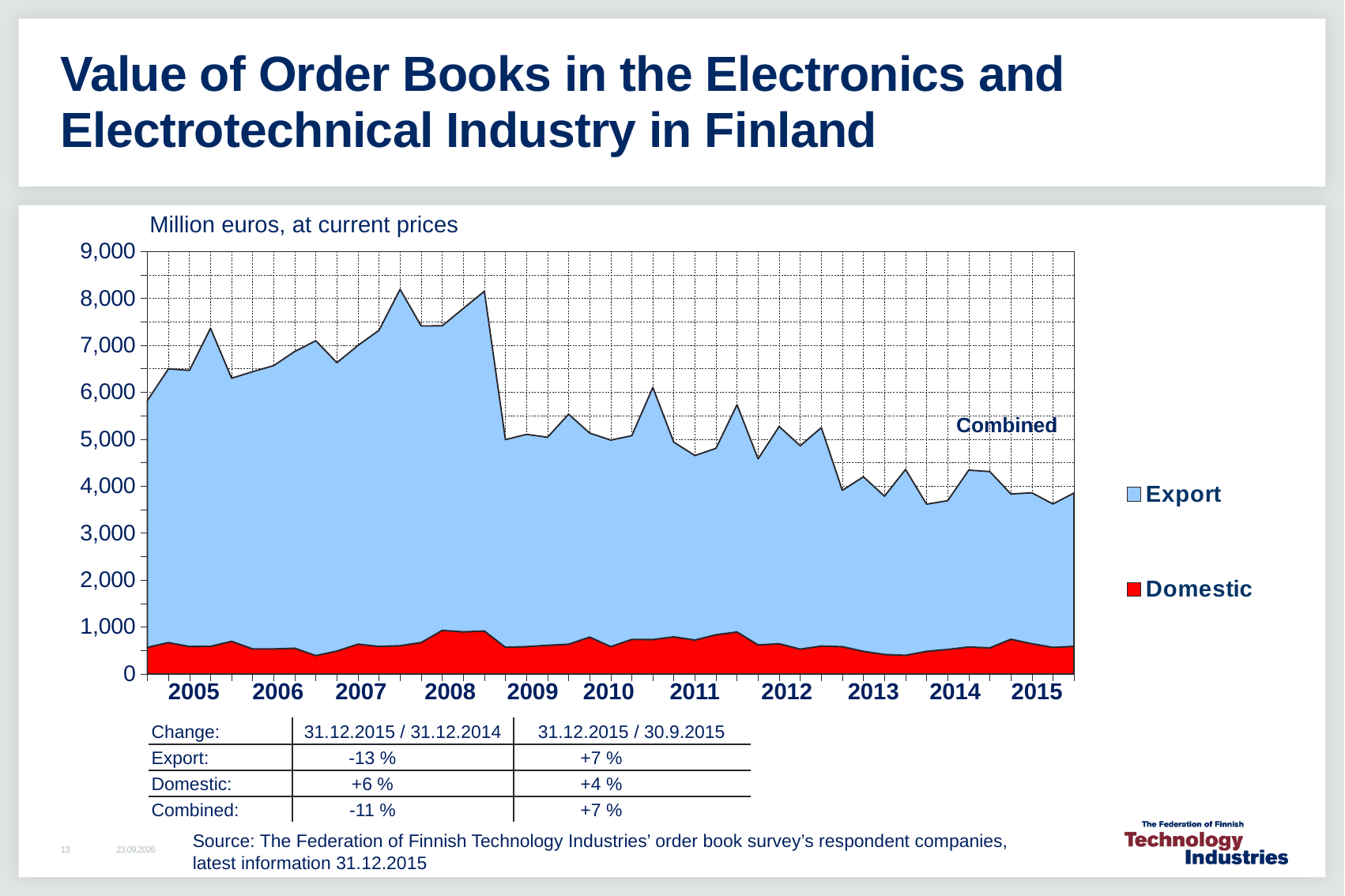
Which series is shown in red? Domestic Is the Domestic value during 2011 greater or less than 2,000? less Is the combined value during 2013 greater or less than 5,000? less Which series is larger in 2010, Export or Domestic? Export Is the combined value at the start of 2005 greater or less than 5,000? greater Does the combined value overall rise or fall from 2008 to 2015? fall What kind of chart is shown on the slide? area chart How many series does the legend list? 2 Is the combined value higher in 2005 or in 2015? 2005 How many years are labelled on the x axis? 11 What unit is stated above the y axis? Million euros, at current prices